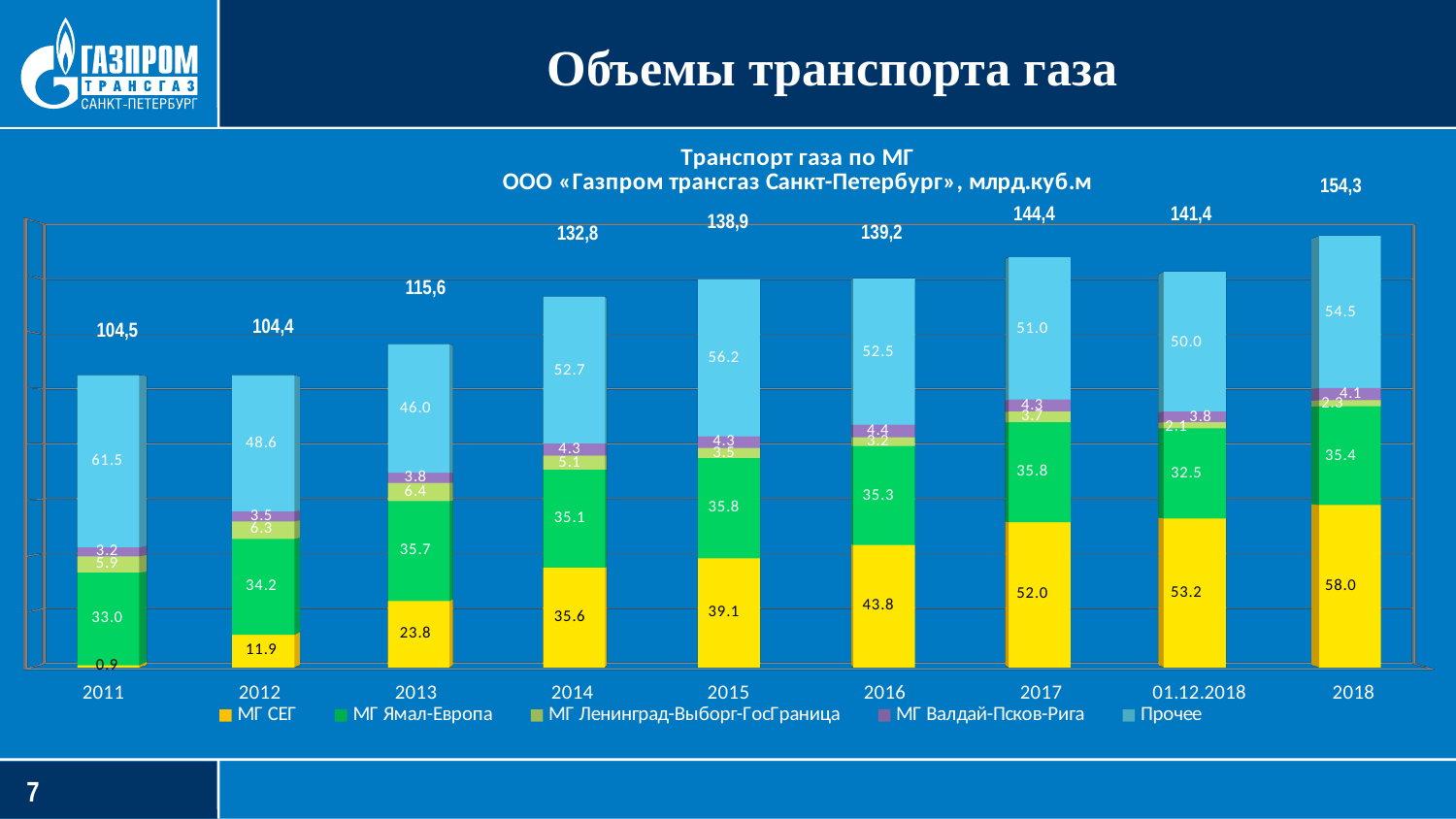
How many categories are shown on the x axis? 9 Which category has the lowest value for МГ СЕГ? 2011 Does the МГ СЕГ value rise or fall from 2011 to 2018? rise What type of chart is shown on the slide? stacked bar chart What is the value of МГ Ямал-Европа for 01.12.2018? 32.5 What is the value of Прочее for 2011? 61.5 What is the value of МГ СЕГ for 2018? 58.0 What is the total labelled above the bar for 2014? 132,8 How many series does the legend list? 5 Which is larger, the Прочее value for 2015 or for 2016? 2015 Which category has the highest total? 2018 What is the difference between the МГ СЕГ values for 2017 and 2016? 8.2